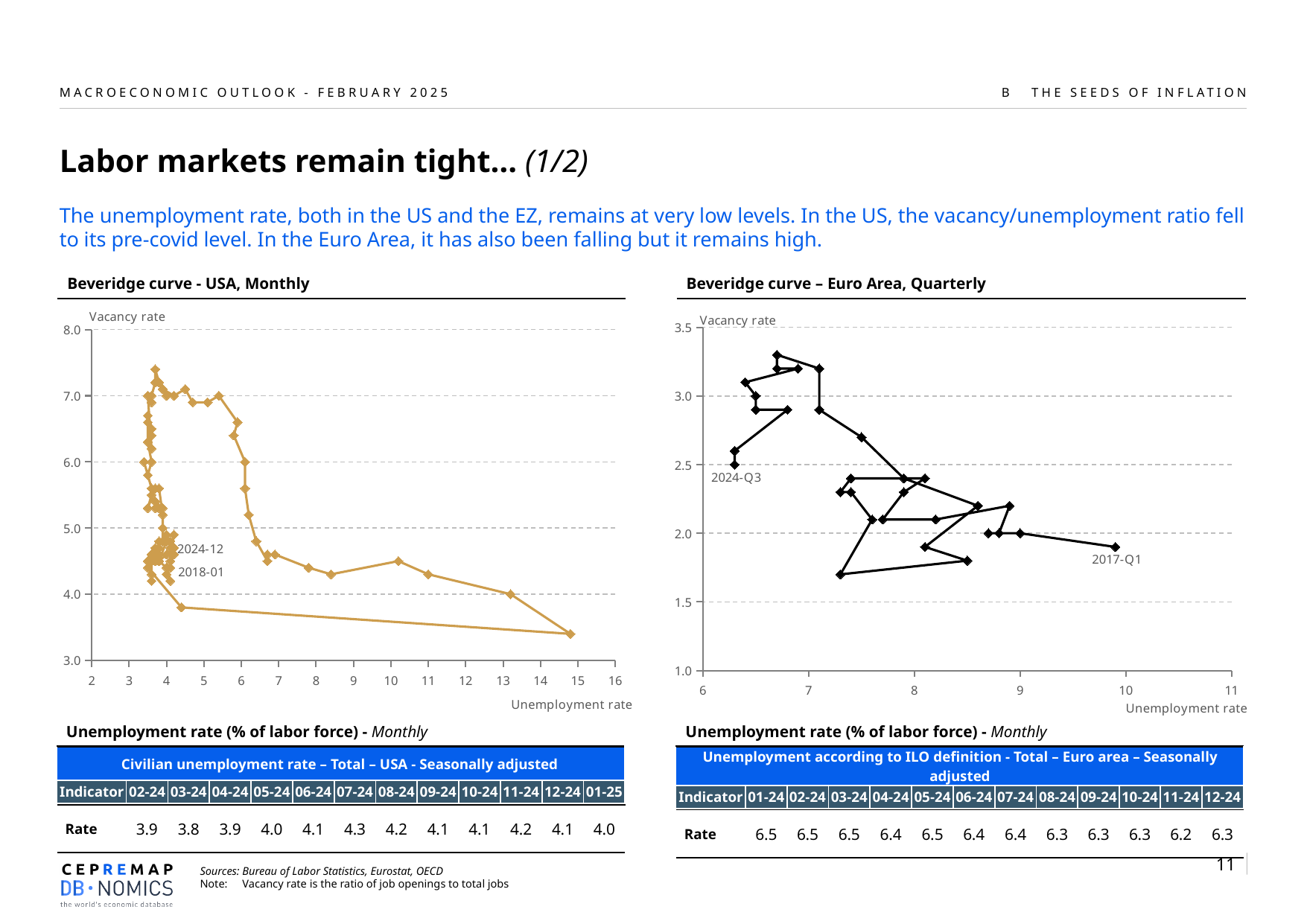
In the 'Beveridge curve – Euro Area, Quarterly' chart, is the unemployment rate for the point labelled 2017-Q1 greater or less than 9? greater What kind of chart is the 'Beveridge curve - USA, Monthly' chart? Scatter/line chart What is the title of the chart on the right side of the slide? Beveridge curve – Euro Area, Quarterly In the 'Beveridge curve - USA, Monthly' chart, is the vacancy rate at the rightmost point (unemployment rate near 15) greater or less than 4.0? less In the 'Beveridge curve – Euro Area, Quarterly' chart, which labelled point has the higher unemployment rate, 2017-Q1 or 2024-Q3? 2017-Q1 In the 'Beveridge curve - USA, Monthly' chart, is the vacancy rate for the point labelled 2018-01 greater or less than 5.0? less In the 'Beveridge curve - USA, Monthly' chart, what variable is plotted on the horizontal axis? Unemployment rate In the 'Beveridge curve - USA, Monthly' chart, which labelled point has the higher vacancy rate, 2024-12 or 2018-01? 2024-12